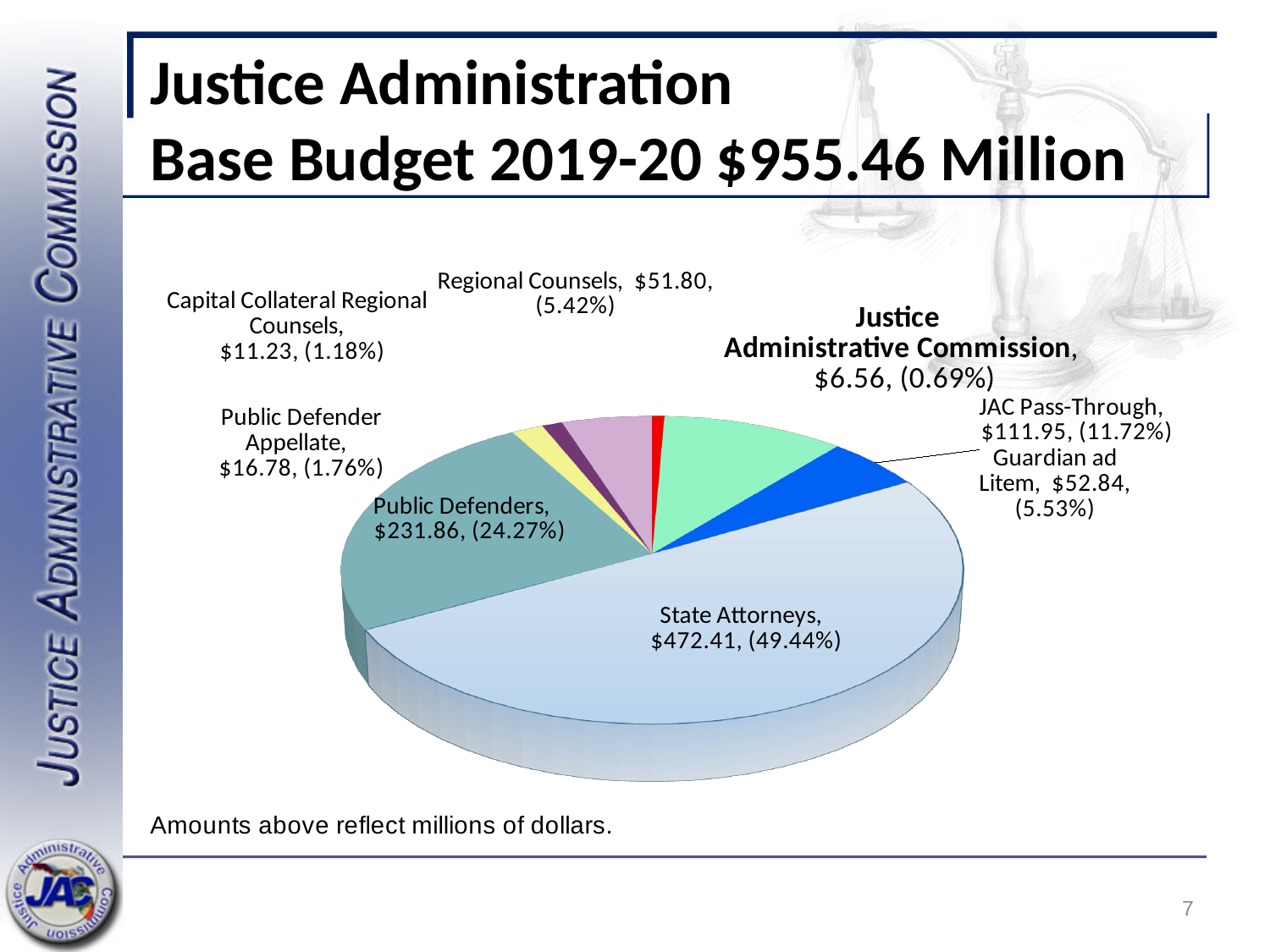
What is the value for Public Defenders? $231.86 What is the difference between the State Attorneys value and the Public Defenders value? $240.55 What is the value for the Justice Administrative Commission slice? $6.56 What is the value for JAC Pass-Through? $111.95 What share of the pie does State Attorneys represent? 49.44% What is the value for Guardian ad Litem? $52.84 How many slices does the pie chart have? 8 Which is larger, JAC Pass-Through or Regional Counsels? JAC Pass-Through What is the value for State Attorneys? $472.41 Which category has the largest slice of the pie? State Attorneys Which category has the smallest slice of the pie? Justice Administrative Commission What share of the pie does Public Defender Appellate represent? 1.76%